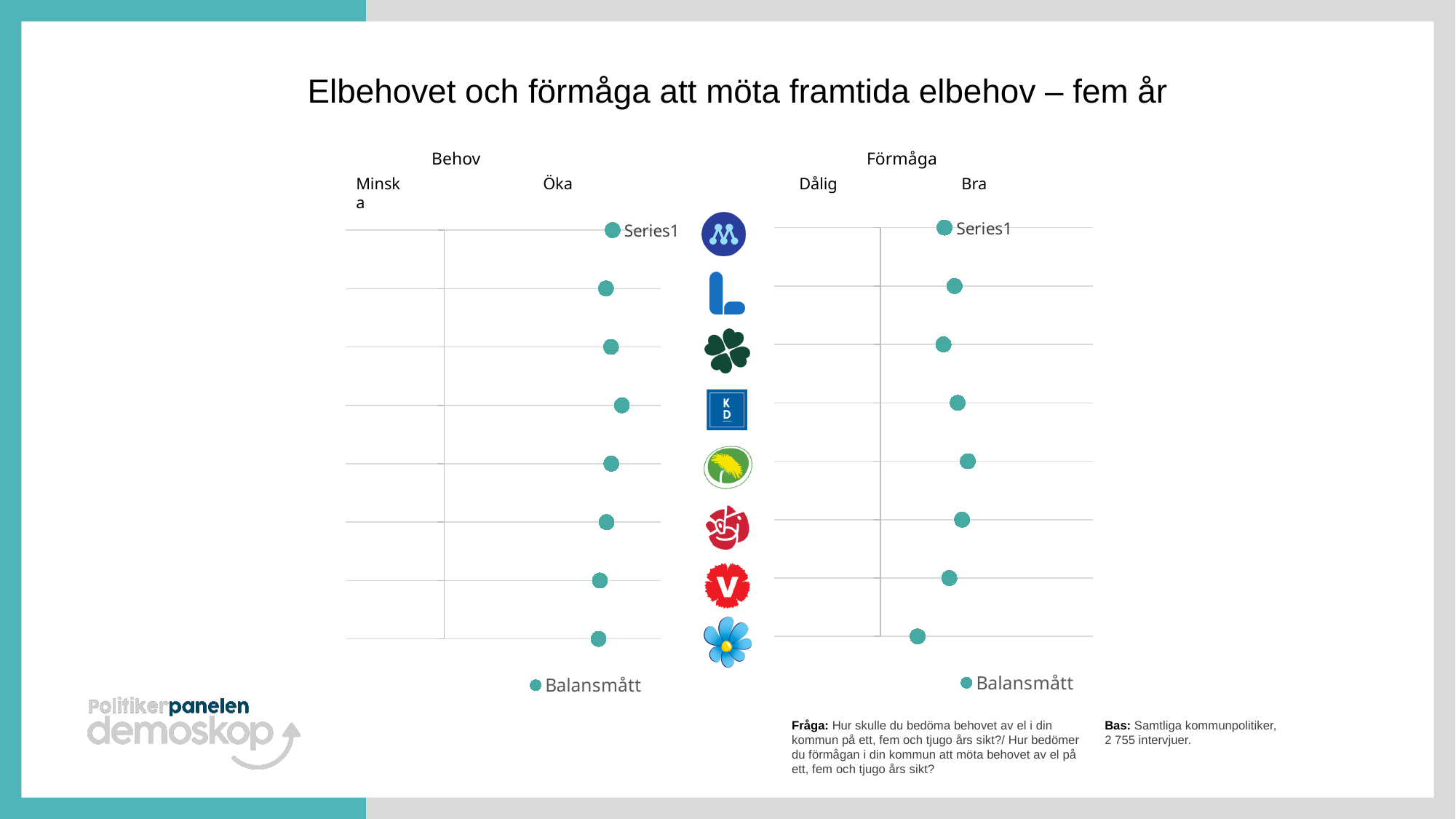
What is the legend entry shown below the Förmåga chart? Balansmått How many data points are plotted in the Förmåga chart on the right? 8 What are the two end labels on the horizontal axis of the Behov chart? Minska and Öka How many data points are plotted in the Behov chart on the left? 8 How many series does the legend below the Behov chart list? 1 In the Behov chart, are the points on the Minska side or the Öka side of the vertical line? Öka How many charts are shown on the slide? 2 In the Förmåga chart, is the point in the bottom row on the Dålig side or the Bra side of the vertical line? Bra In the Förmåga chart, which row's point lies furthest toward Dålig? the bottom row What kind of chart is the Behov chart on the left? dot plot